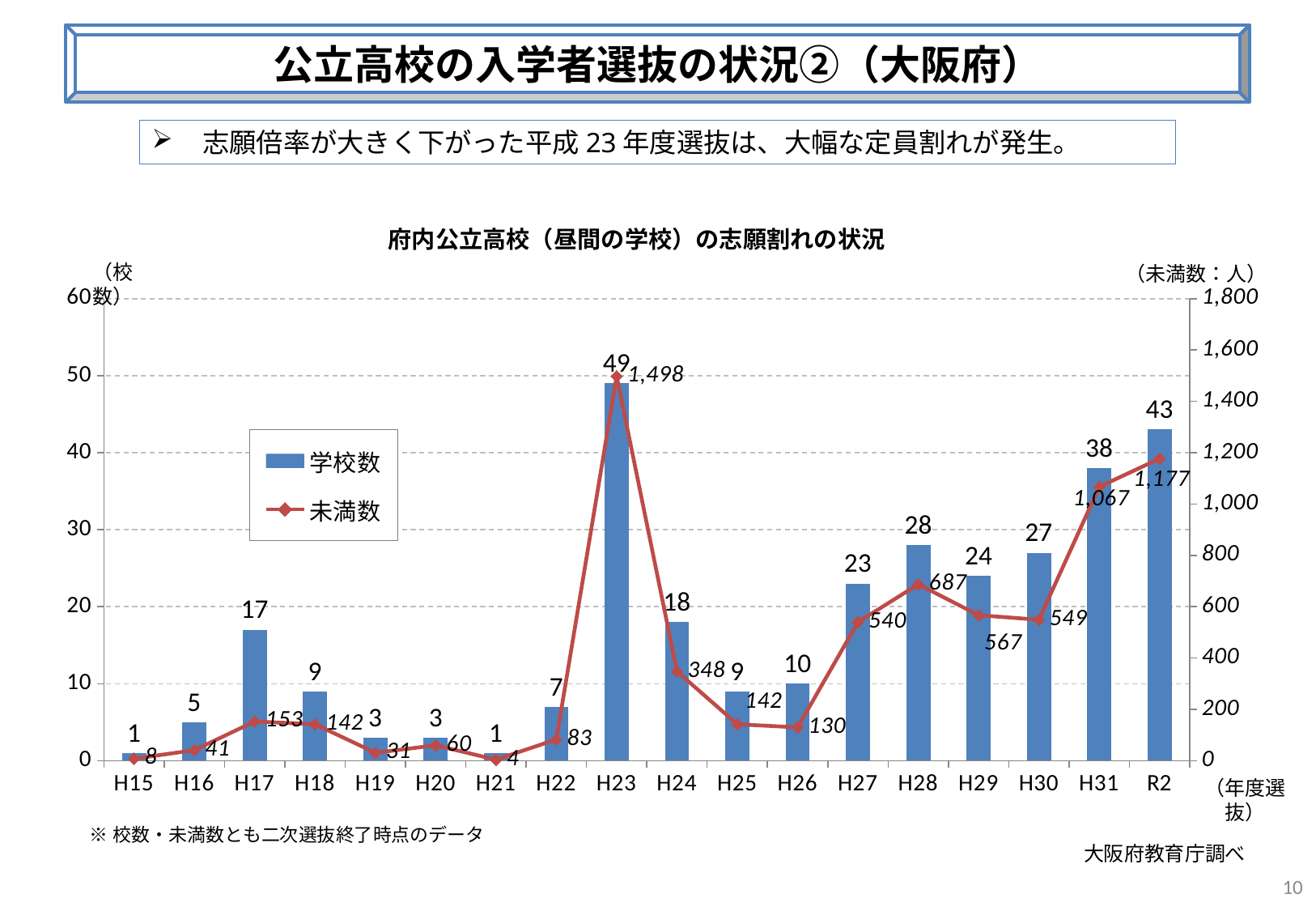
Which year has the lowest 未満数? H21 What is the 学校数 value for H31? 38 Which has a larger 未満数, H29 or H30? H29 What kind of chart is used for the 学校数 series? Bar chart Does the 学校数 rise or fall from H27 to H28? Rise What is the difference in 学校数 between R2 and H31? 5 What is the 未満数 value for R2? 1,177 How many series does the legend list? 2 How many years are shown on the x axis? 18 What is the 未満数 value for H28? 687 What is the 学校数 value for H23? 49 Which year has the highest 未満数? H23